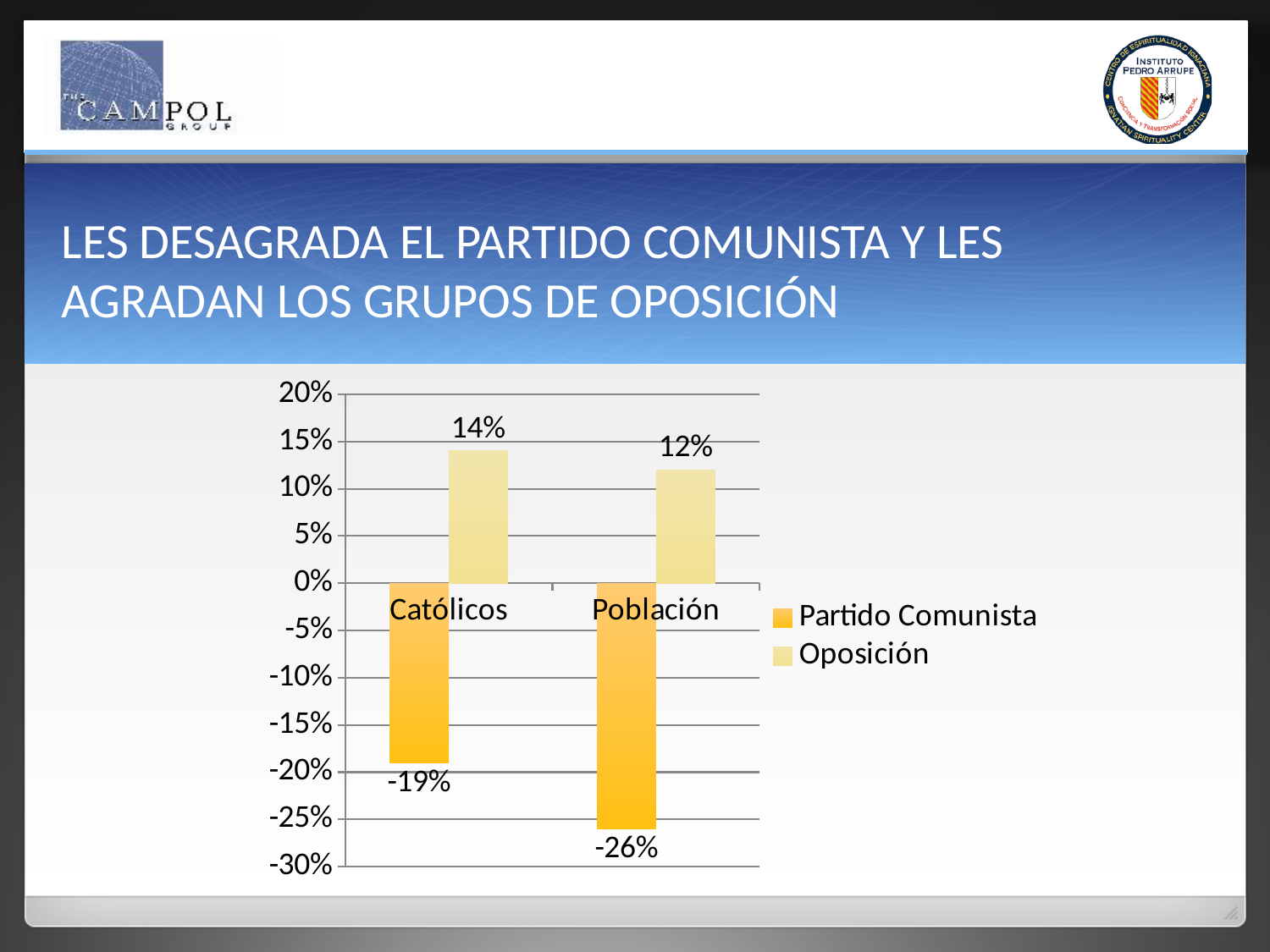
What is the value for Oposición among Población? 12% Which category has the lowest value for Partido Comunista? Población What kind of chart is shown on the slide? bar chart What is the difference between the Oposición values for Católicos and Población? 2% Which category has the highest value for Oposición? Católicos What is the value for Partido Comunista among Población? -26% Is the Oposición value for Católicos larger or smaller than the Oposición value for Población? larger How many categories are shown on the x axis? 2 How many series does the legend list? 2 What is the value for Oposición among Católicos? 14% What is the value for Partido Comunista among Católicos? -19% What is the difference between the Partido Comunista values for Católicos and Población? 7%